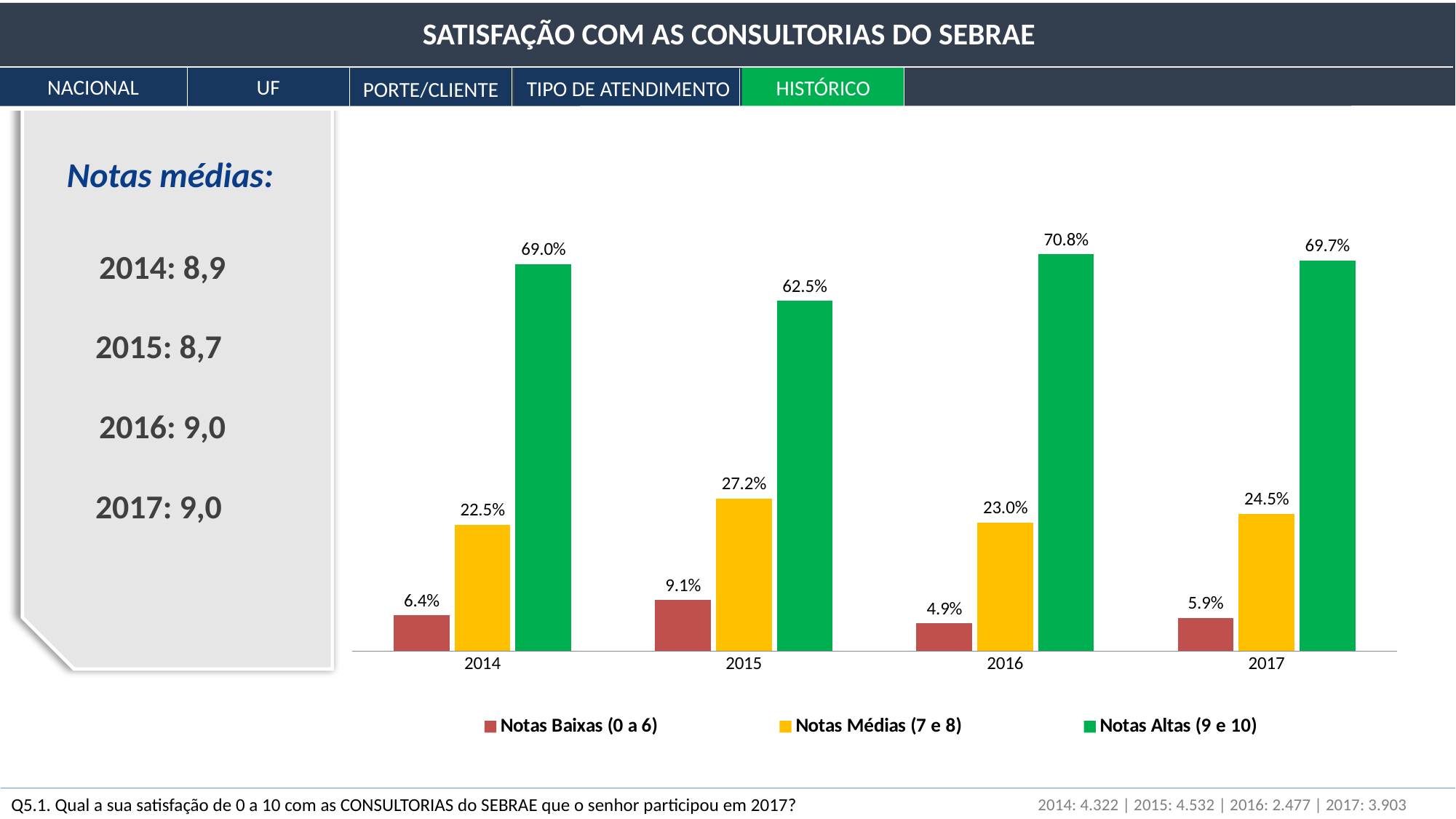
Which colour represents Notas Altas (9 e 10) in the legend? green What kind of chart is shown? bar chart Which is larger: Notas Médias (7 e 8) in 2015 or in 2016? 2015 What is the value for Notas Médias (7 e 8) in 2017? 24.5% What is the value for Notas Altas (9 e 10) in 2016? 70.8% What is the value for Notas Baixas (0 a 6) in 2015? 9.1% In which year is the Notas Baixas (0 a 6) value highest? 2015 How many series does the legend list? 3 How many years are shown on the x axis? 4 Does the Notas Baixas (0 a 6) value rise or fall from 2015 to 2016? fall What is the difference between the Notas Altas (9 e 10) values for 2016 and 2015? 8.3% In which year is the Notas Altas (9 e 10) value lowest? 2015